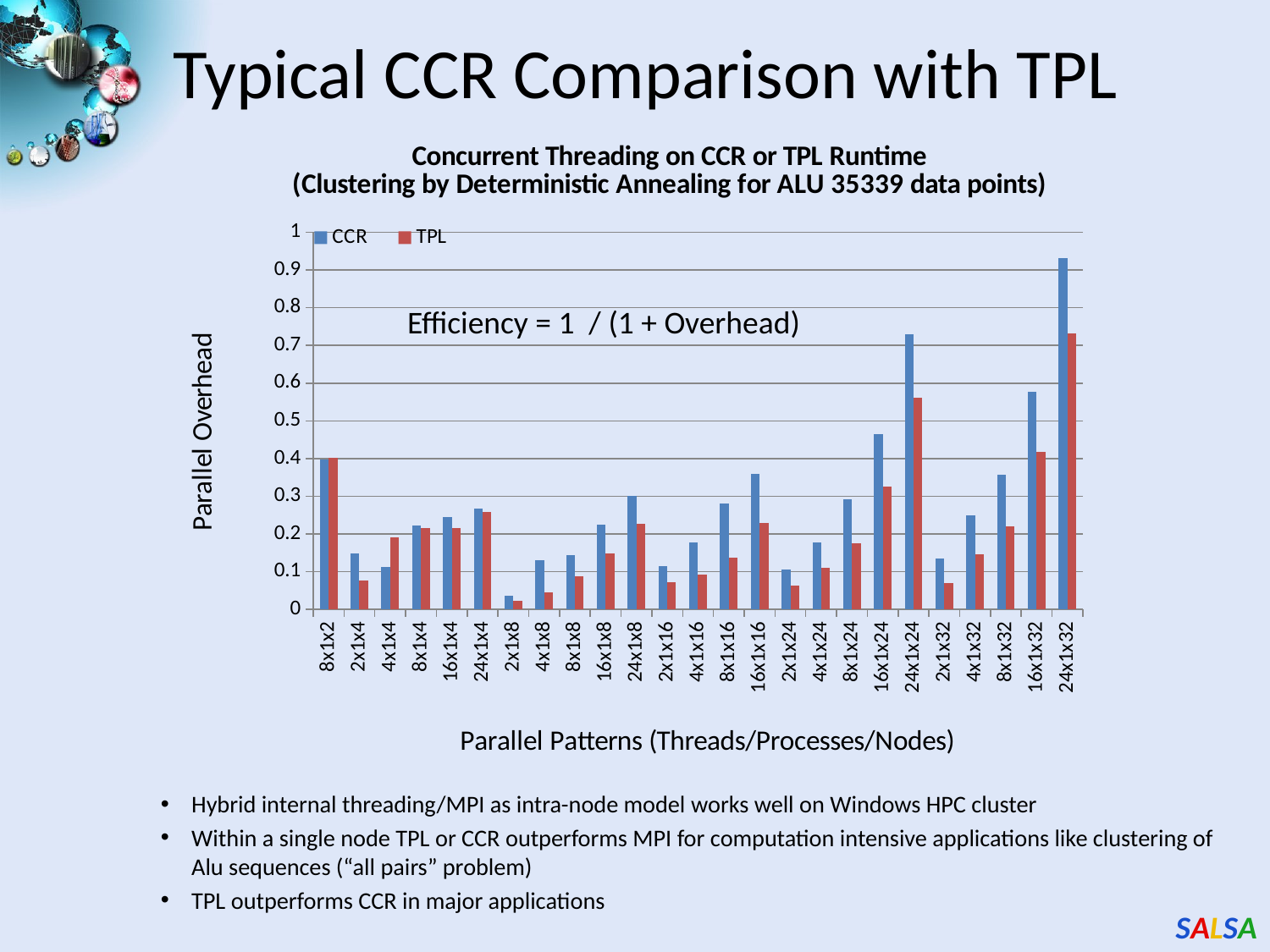
Which parallel pattern has the highest CCR parallel overhead? 24x1x32 Is the TPL value for 2x1x4 greater or less than 0.1? less How many parallel pattern categories are shown on the x axis? 25 Is the TPL value for 24x1x24 greater or less than 0.5? greater What kind of chart is shown on the slide? bar chart Which parallel pattern has the lowest CCR parallel overhead? 2x1x8 How many series does the legend list? 2 Is the CCR value for 16x1x24 greater or less than 0.5? less Which parallel pattern has the highest TPL parallel overhead? 24x1x32 What is the label of the y axis? Parallel Overhead For 16x1x32, which is larger, the CCR value or the TPL value? CCR